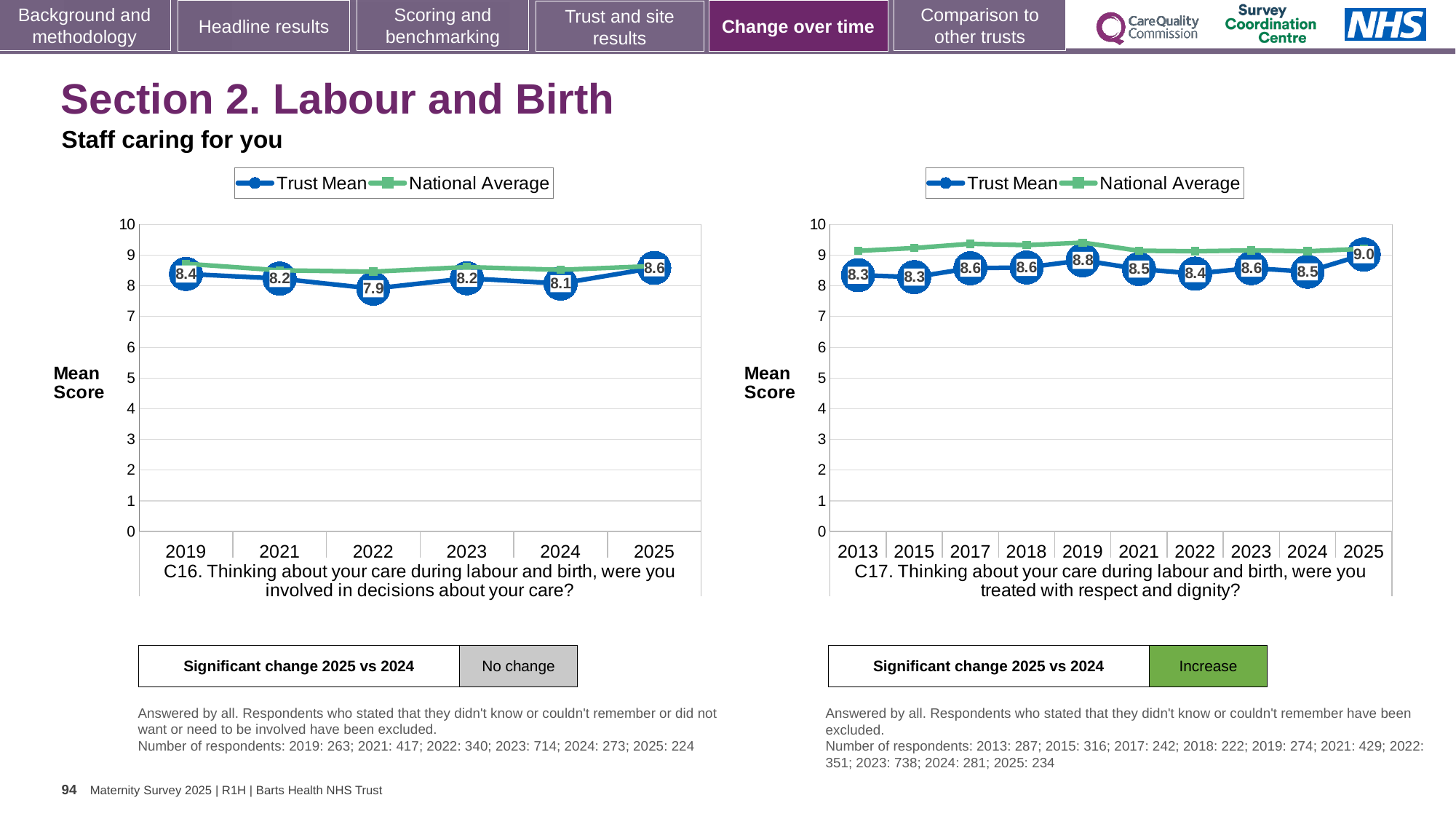
In the C16 chart (left), what is the Trust Mean for 2022? 7.9 In the C16 chart (left), is the National Average for 2019 greater or less than 8? greater In the C17 chart (right), which year has the highest Trust Mean? 2025 In the C16 chart (left), how many years are shown on the x axis? 6 In the C17 chart (right), what is the difference between the Trust Mean for 2025 and 2013? 0.7 In the C17 chart (right), is the Trust Mean higher in 2022 or 2023? 2023 In the C16 chart (left), what is the difference between the Trust Mean for 2025 and 2024? 0.5 How many series does the legend of the C17 chart (right) list? 2 In the C17 chart (right), how many years are plotted? 10 In the C17 chart (right), what is the Trust Mean for 2019? 8.8 In the C16 chart (left), which year has the lowest Trust Mean? 2022 In the C16 chart (left), what is the Trust Mean for 2025? 8.6